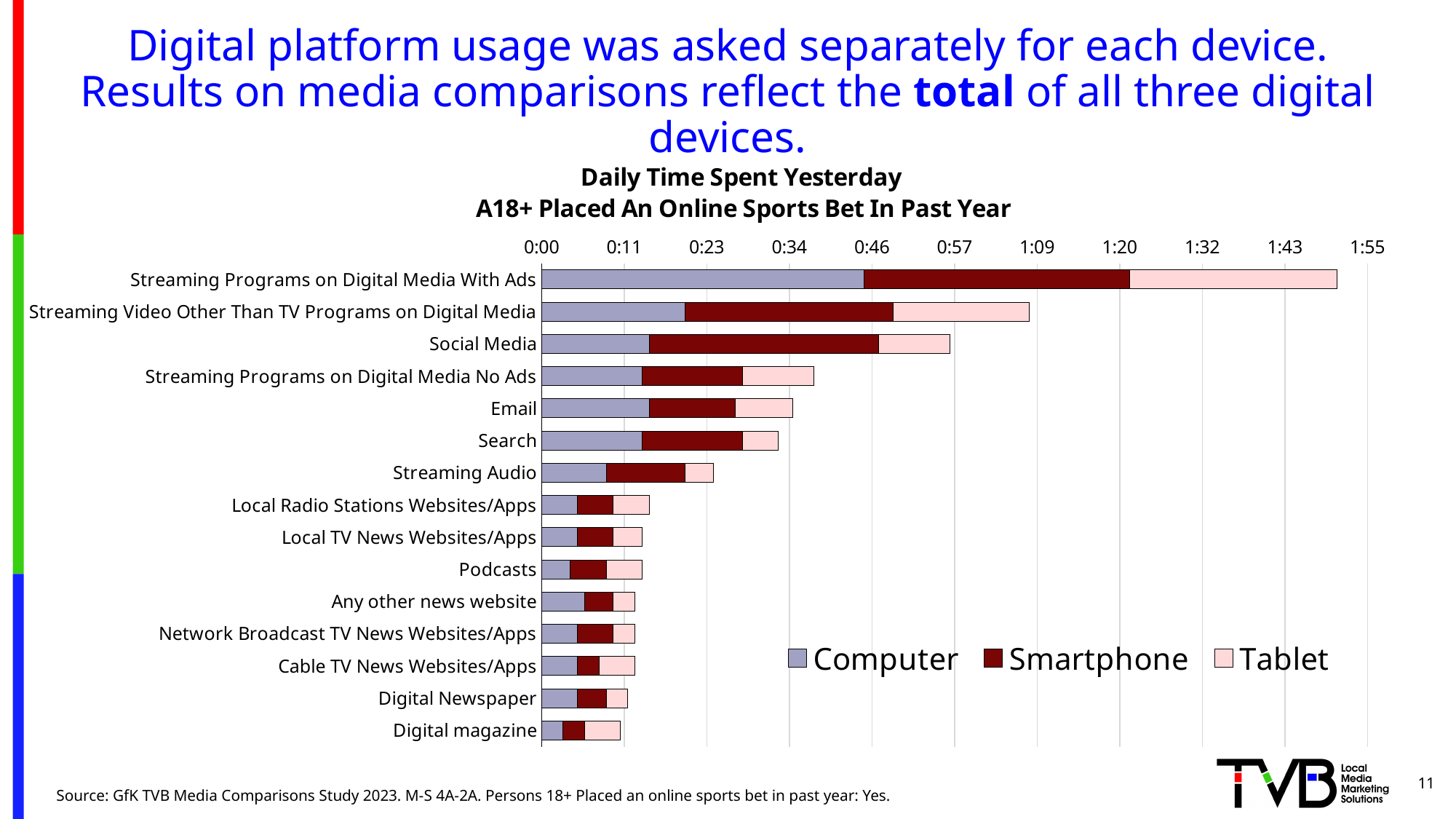
Which has the longer total bar: Streaming Audio or Local Radio Stations Websites/Apps? Streaming Audio Do the total bar lengths increase or decrease going from the top category to the bottom category? decrease Is the total bar for Streaming Programs on Digital Media With Ads greater or less than 1:43? greater How many series does the legend list? 3 Is the total bar for Email greater or less than 0:46? less Which category has the longest total bar? Streaming Programs on Digital Media With Ads Is the total bar for Social Media greater or less than 1:09? less How many categories are plotted on the chart? 15 What kind of chart is shown on the slide? Stacked bar chart Which has the longer total bar: Social Media or Streaming Video Other Than TV Programs on Digital Media? Streaming Video Other Than TV Programs on Digital Media Which series is shown in dark red in the legend? Smartphone